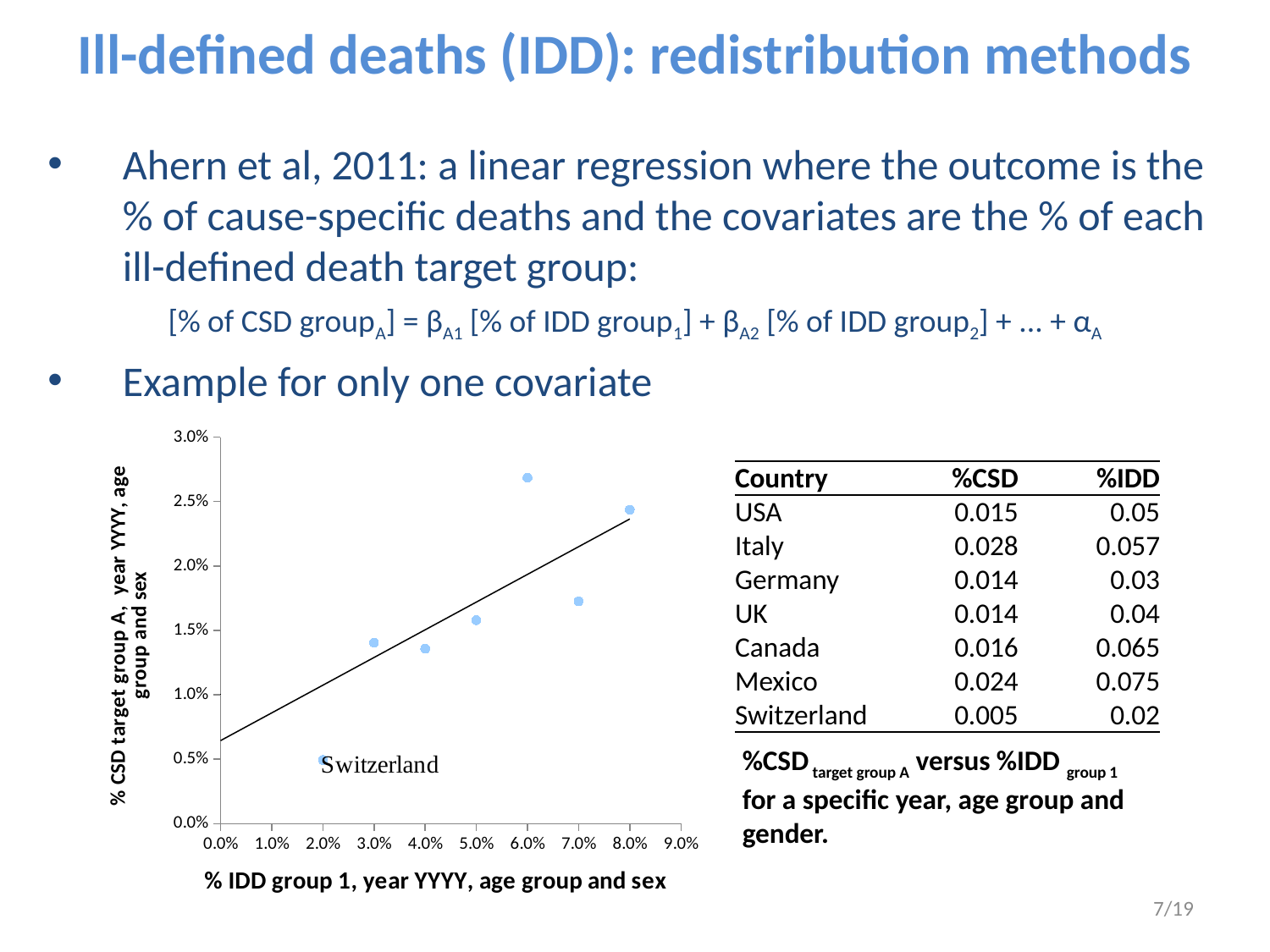
How many data points are plotted in the scatter chart? 7 At which x-axis value does the point with the highest % CSD target group A value lie? 6.0% What kind of chart is shown on the slide? scatter chart Is the % CSD value of the point at 3.0% IDD greater or less than 1.5%? less Is the % CSD value of the point at 6.0% IDD greater or less than 2.5%? greater What is the x-axis value (% IDD group 1) of the Switzerland point? 2.0% Which country is labelled on the scatter chart? Switzerland Which labelled point has the lowest % CSD target group A value? Switzerland What is the y-axis value (% CSD target group A) of the Switzerland point? 0.5% Is the % CSD value of the point at 7.0% IDD greater or less than 1.5%? greater Does the fitted line in the scatter chart rise or fall as % IDD group 1 increases? rise Which point has a higher % CSD value: the one at 6.0% IDD or the one at 7.0% IDD? the one at 6.0% IDD